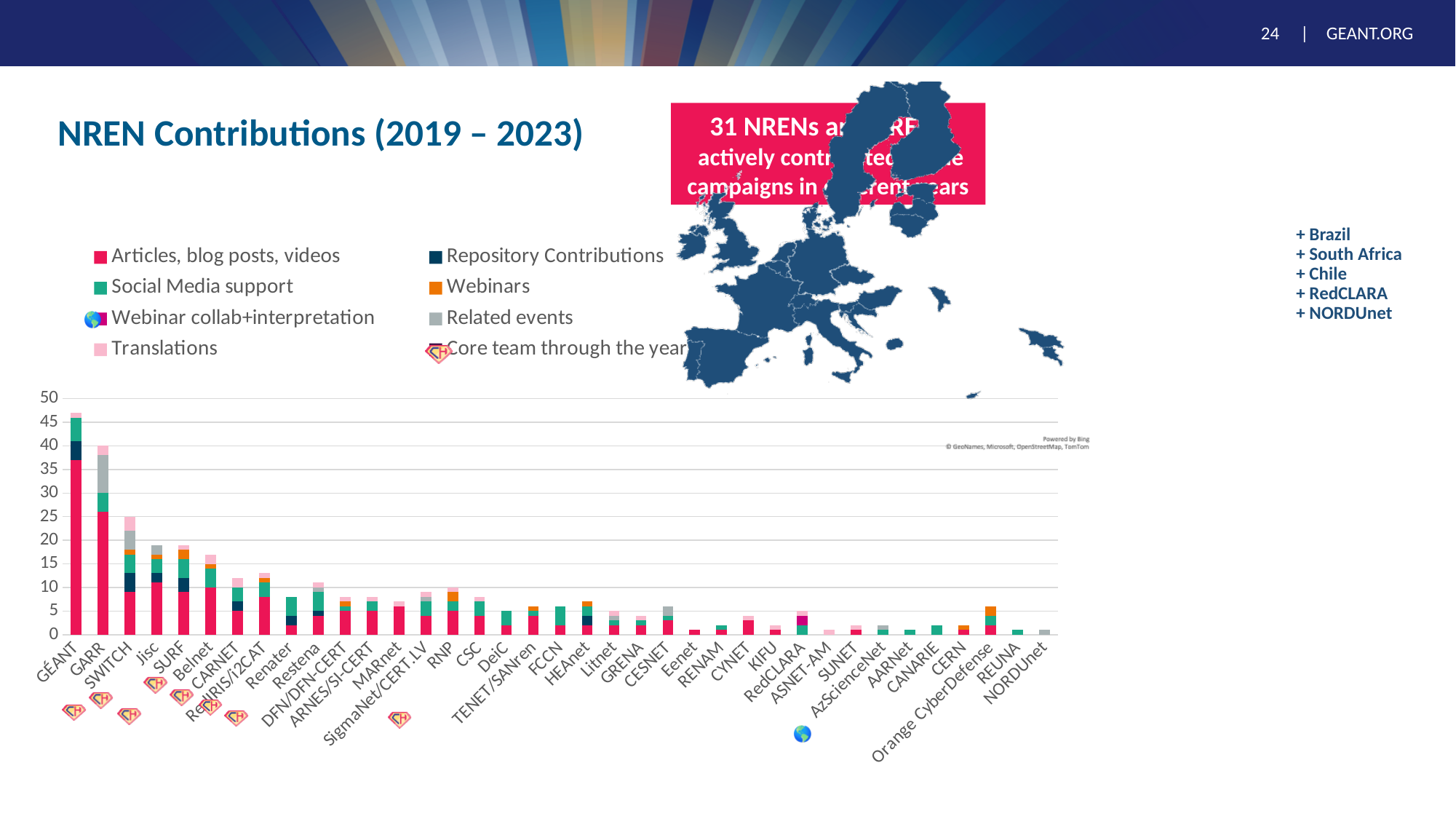
What kind of chart is shown on the slide? Stacked bar chart Is the total value for CARNET greater or less than 10? greater Which has the larger total bar, Renater or Restena? Restena What is the title of the chart on the slide? NREN Contributions (2019 – 2023) Is the total value for SWITCH greater or less than 20? greater Is the total value for Renater greater or less than 10? less Do the total bar values generally rise or fall from left to right along the x axis? Fall Which colour represents the 'Articles, blog posts, videos' series in the legend? Red/pink Which NREN has the highest total bar in the chart? GÉANT Which has the larger total bar, GÉANT or GARR? GÉANT